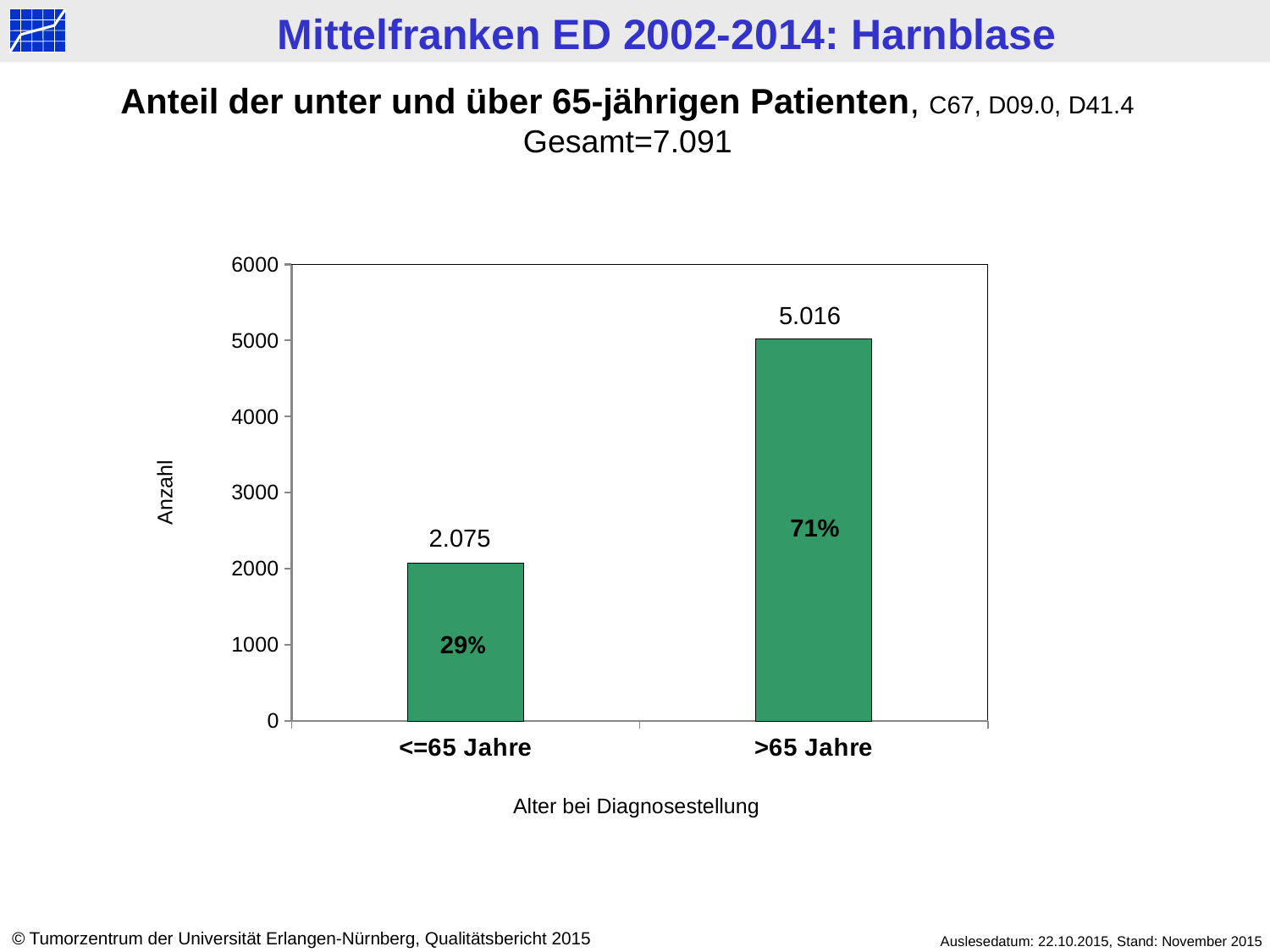
What is the value for the "<=65 Jahre" category? 2.075 What is the value for the ">65 Jahre" category? 5.016 How many categories are shown on the x axis? 2 Which is larger, the value for "<=65 Jahre" or the value for ">65 Jahre"? >65 Jahre What percentage is shown on the ">65 Jahre" bar? 71% Which category has the highest value? >65 Jahre What is the difference between the values for ">65 Jahre" and "<=65 Jahre"? 2.941 Which category has the lowest value? <=65 Jahre What percentage is shown on the "<=65 Jahre" bar? 29% What is the label of the x axis? Alter bei Diagnosestellung What kind of chart is shown on the slide? bar chart Is the value for "<=65 Jahre" greater or less than 3000? less